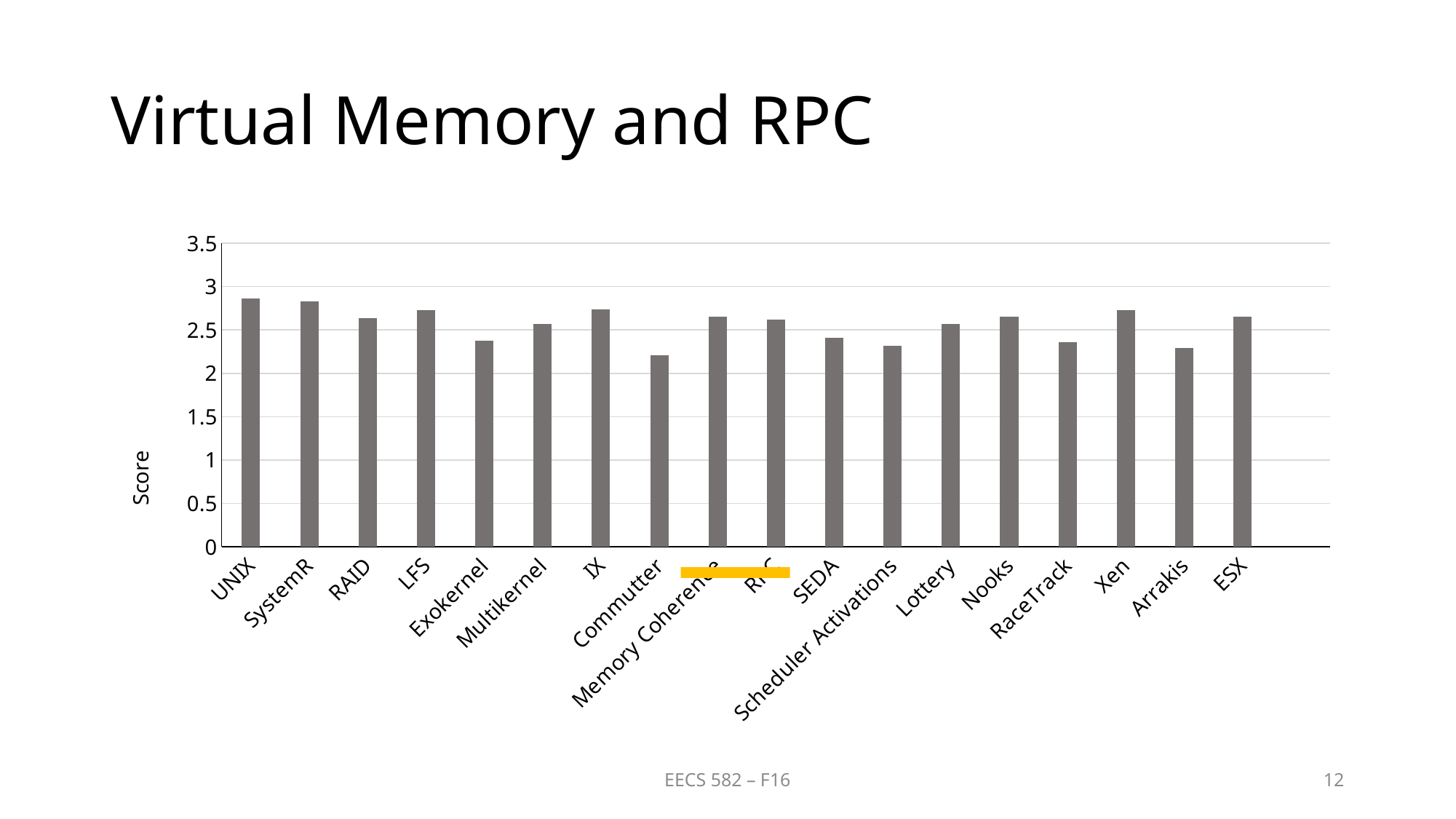
Which has a higher score, Xen or Arrakis? Xen Is the value for Exokernel greater or less than 2.5? less Which category has the lowest score? Commutter What kind of chart is shown on the slide? bar chart How many bars (categories) does the chart show? 18 Is the value for UNIX greater or less than 2.5? greater Which has a higher score, UNIX or Commutter? UNIX Is the value for Commutter greater or less than 2.5? less What is the label on the vertical axis of the chart? Score Which has a higher score, LFS or Exokernel? LFS